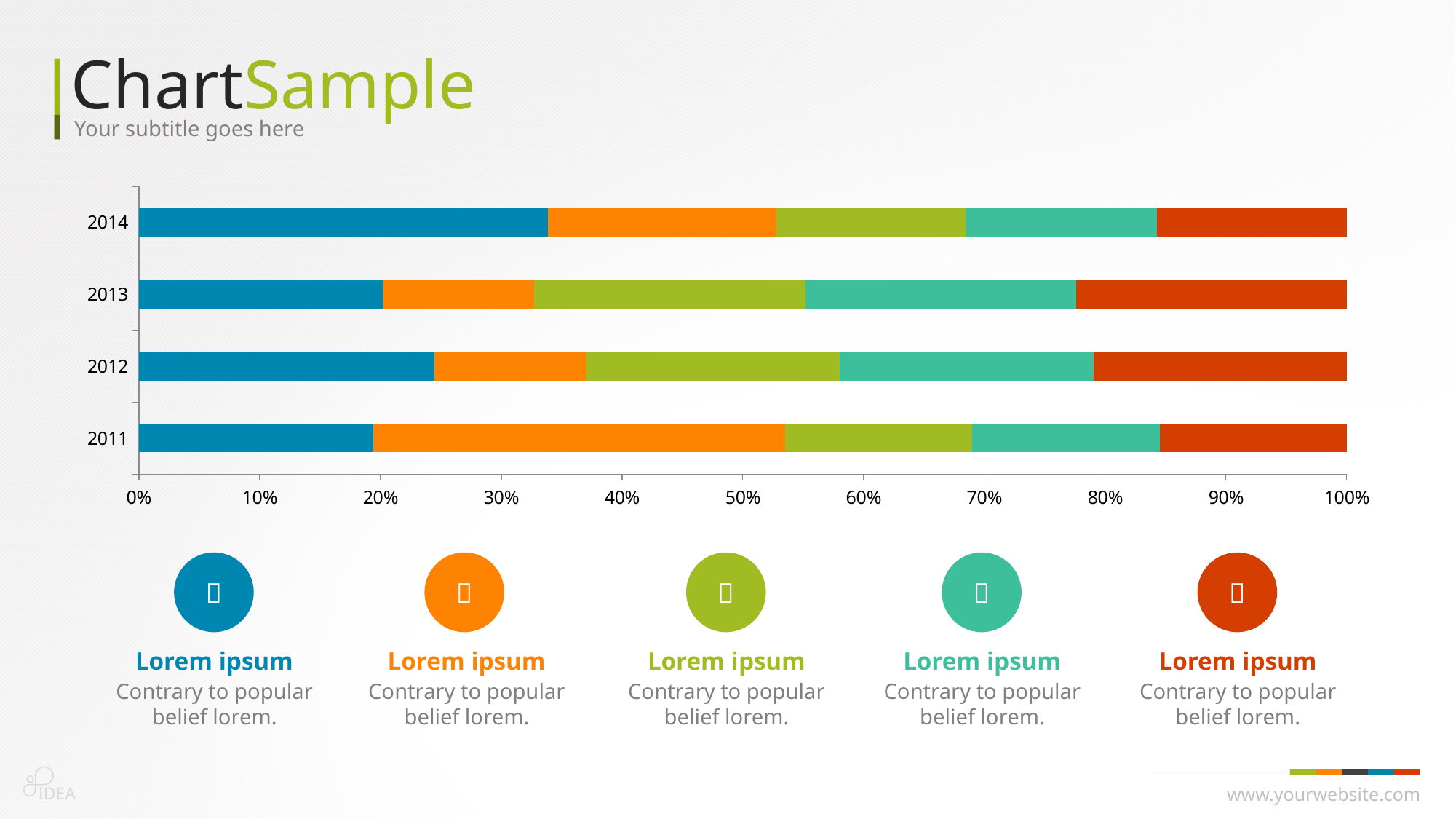
What is the total of the stacked bar for 2014? 100% Which is larger: the green (third) segment for 2013 or for 2011? 2013 Which year has the largest blue (first) segment? 2014 Which year has the largest orange (second) segment? 2011 Which is larger: the blue (first) segment for 2014 or for 2013? 2014 What kind of chart is shown on the slide? Stacked bar chart Is the orange (second) segment for 2013 greater or less than 20%? less How many coloured series make up each bar in the chart? 5 What is the title of the slide containing the chart? Chart Sample Is the blue (first) segment for 2012 greater or less than 20%? greater Is the blue (first) segment for 2014 greater or less than 30%? greater How many years (categories) are plotted on the chart? 4